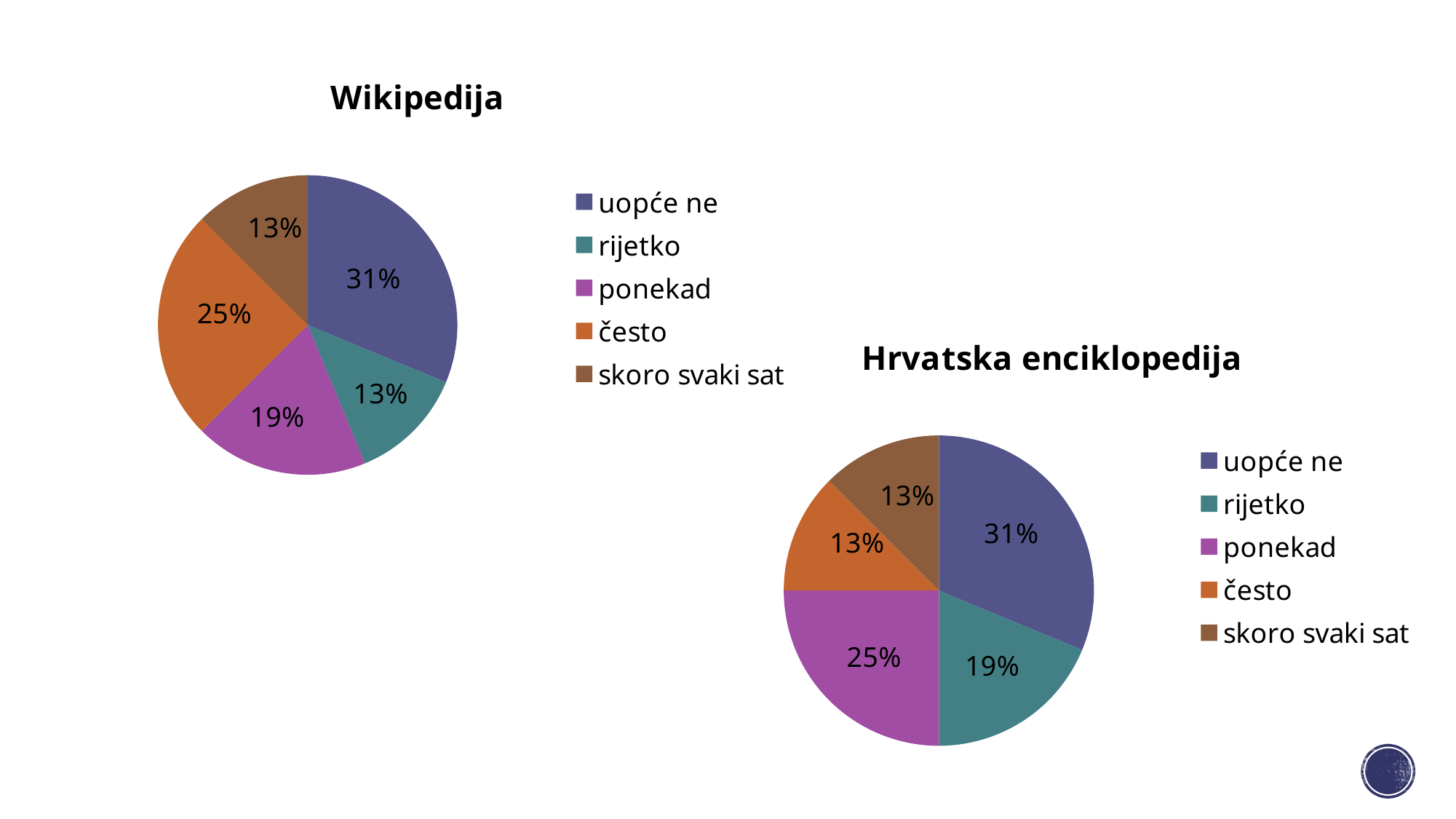
In the Hrvatska enciklopedija chart, what share is labelled for "rijetko"? 19% In the Hrvatska enciklopedija chart, what is the difference between the shares for "ponekad" and "često"? 12% What kind of chart is the Wikipedija chart? pie chart In the Hrvatska enciklopedija chart, what share is labelled for "ponekad"? 25% What is the title of the chart on the right side of the slide? Hrvatska enciklopedija In the Wikipedija chart, what is the difference between the shares for "uopće ne" and "često"? 6% In the Wikipedija chart, what share is labelled for "često"? 25% How many categories does the legend of the Hrvatska enciklopedija chart list? 5 In the Wikipedija chart, which is larger, the share for "ponekad" or the share for "rijetko"? ponekad In the Hrvatska enciklopedija chart, which category has the largest slice? uopće ne In the Wikipedija chart, what share is labelled for "ponekad"? 19% In the Wikipedija chart, which category has the largest slice? uopće ne